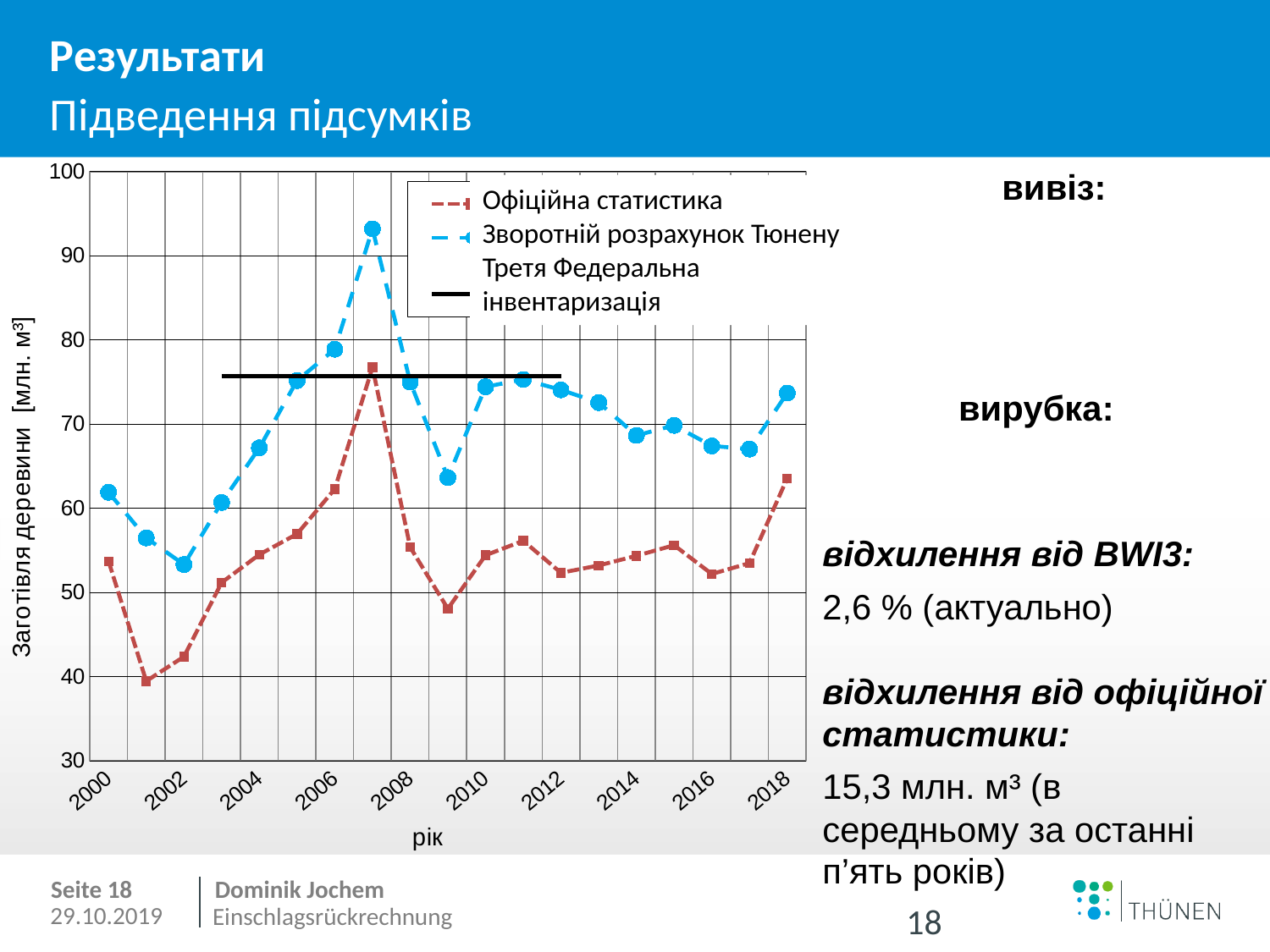
Which series has the larger value in 2007, 'Офіційна статистика' or 'Зворотній розрахунок Тюнену'? Зворотній розрахунок Тюнену Does the 'Офіційна статистика' series rise or fall from 2000 to 2001? fall What kind of chart is shown on the slide? line chart Is the value for 'Зворотній розрахунок Тюнену' in 2007 greater or less than 90? greater What is the label of the vertical axis of the chart? Заготівля деревини [млн. м³] In which year does the 'Офіційна статистика' series reach its lowest value? 2001 In which year does the 'Зворотній розрахунок Тюнену' series reach its lowest value? 2002 Is the value for 'Зворотній розрахунок Тюнену' in 2009 greater or less than 70? less In which year does the 'Офіційна статистика' series reach its highest value? 2007 Is the value for 'Офіційна статистика' in 2001 greater or less than 50? less In which year does the 'Зворотній розрахунок Тюнену' series reach its highest value? 2007 How many series does the chart legend list? 3